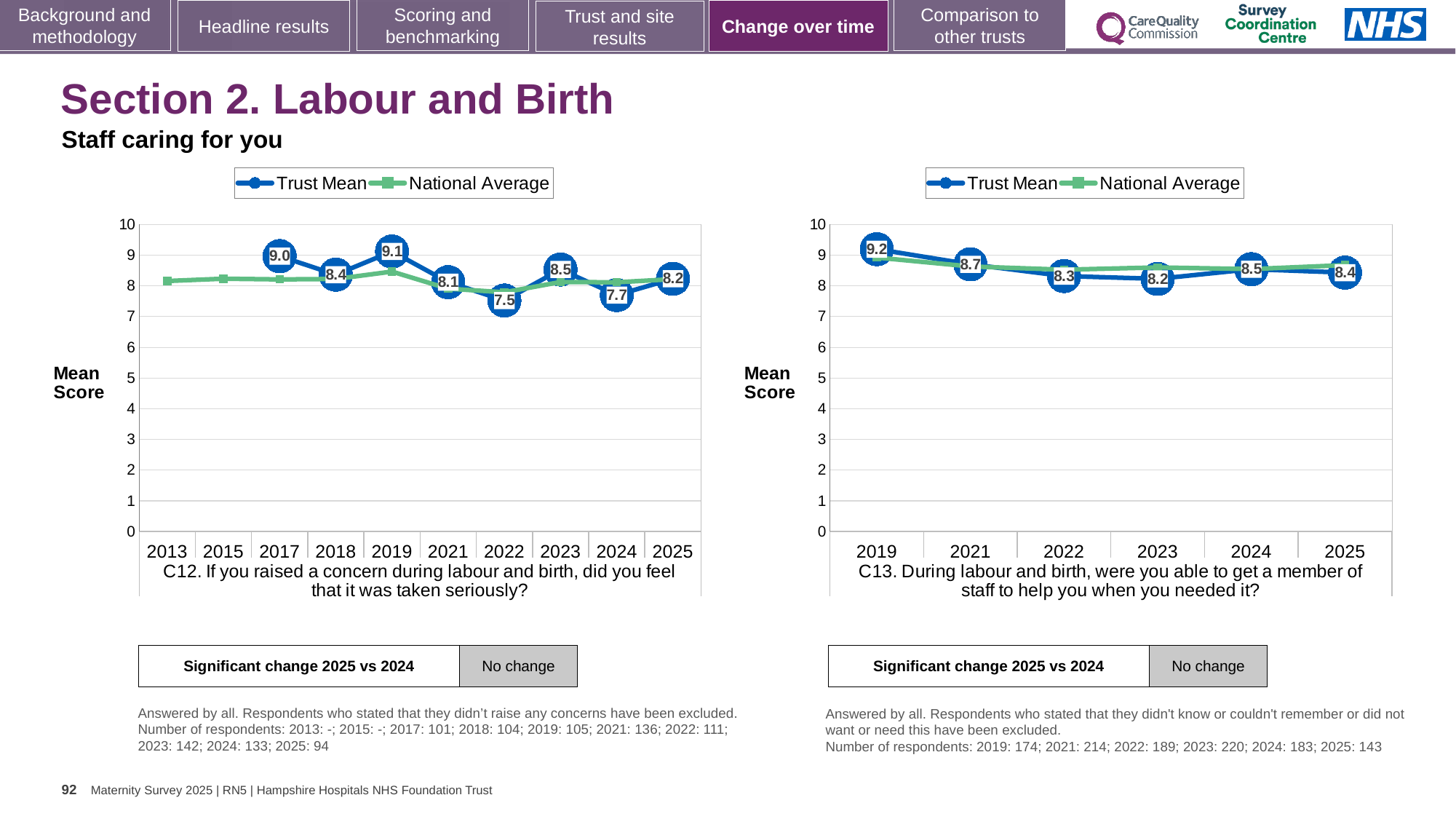
How many series does the legend of the C13 chart (right) list? 2 In the C12 chart (left), is the National Average for 2013 greater or less than 9? less In the C12 chart (left), what is the difference between the Trust Mean in 2019 and in 2022? 1.6 In the C13 chart (right), what is the Trust Mean for 2019? 9.2 In the C12 chart (left), which year has the highest Trust Mean? 2019 In the C12 chart (left), what is the Trust Mean for 2025? 8.2 What type of chart is the C12 chart (left)? Line chart In the C12 chart (left), which year has the lowest Trust Mean? 2022 In the C13 chart (right), how many years are shown on the x axis? 6 In the C13 chart (right), is the Trust Mean higher in 2024 or in 2025? 2024 In the C12 chart (left), what is the Trust Mean for 2022? 7.5 In the C13 chart (right), which year has the lowest Trust Mean? 2023